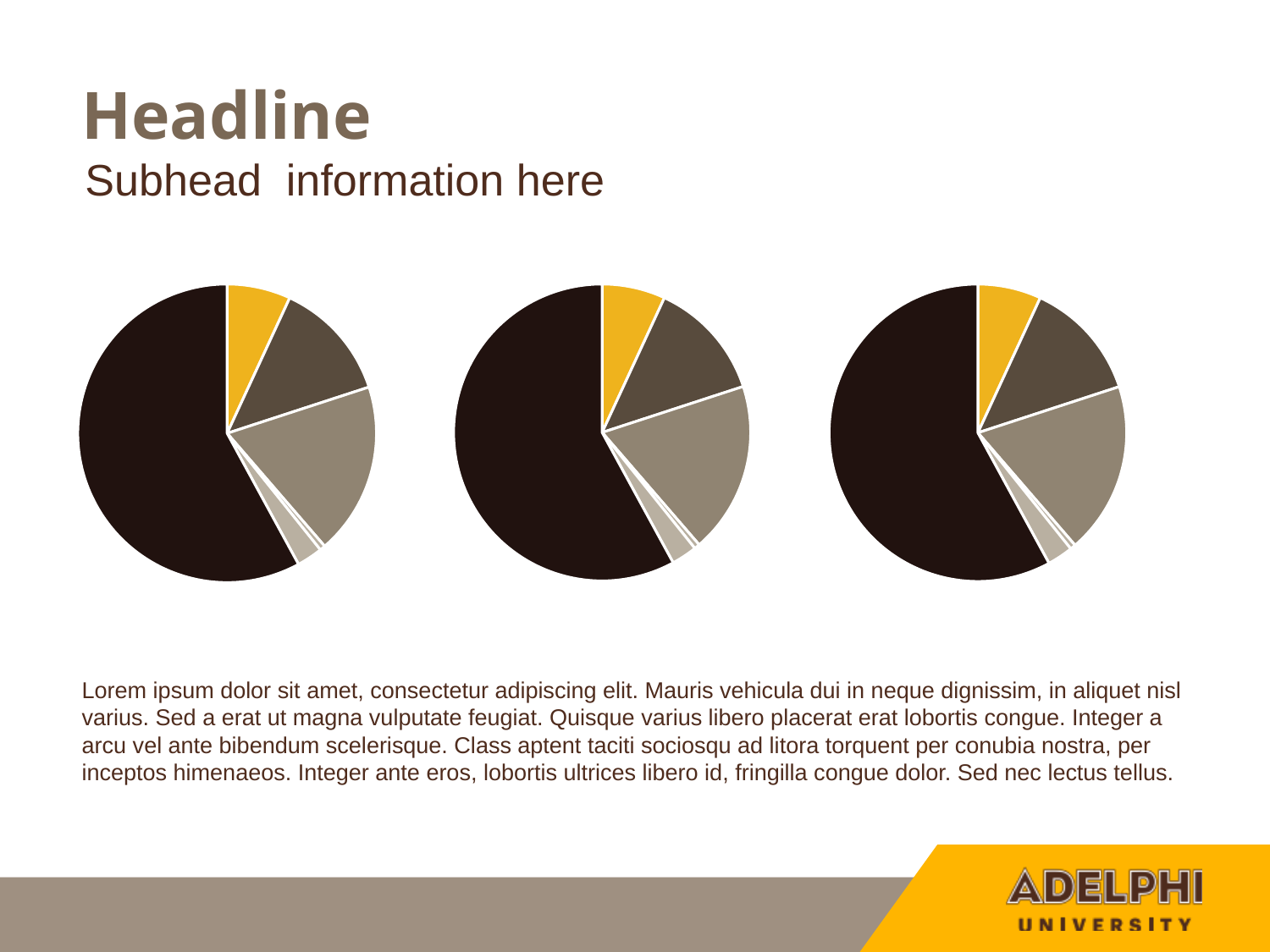
Do the pie charts on the slide have a legend? No Do the pie charts on the slide show data labels with values? No What kind of chart is the middle chart on the slide? pie chart In the right pie chart, which colour slice is the largest? dark brown In the middle pie chart, is the dark brown slice more or less than half of the pie? more What kind of chart is the right chart on the slide? pie chart What kind of chart is the left chart on the slide? pie chart In the left pie chart, which colour slice is the largest? dark brown In the left pie chart, which is larger, the yellow slice or the tan slice? the tan slice In the right pie chart, which is larger, the yellow slice or the dark brown slice? the dark brown slice How many pie charts are shown on the slide? 3 In the middle pie chart, which colour slice is the largest? dark brown